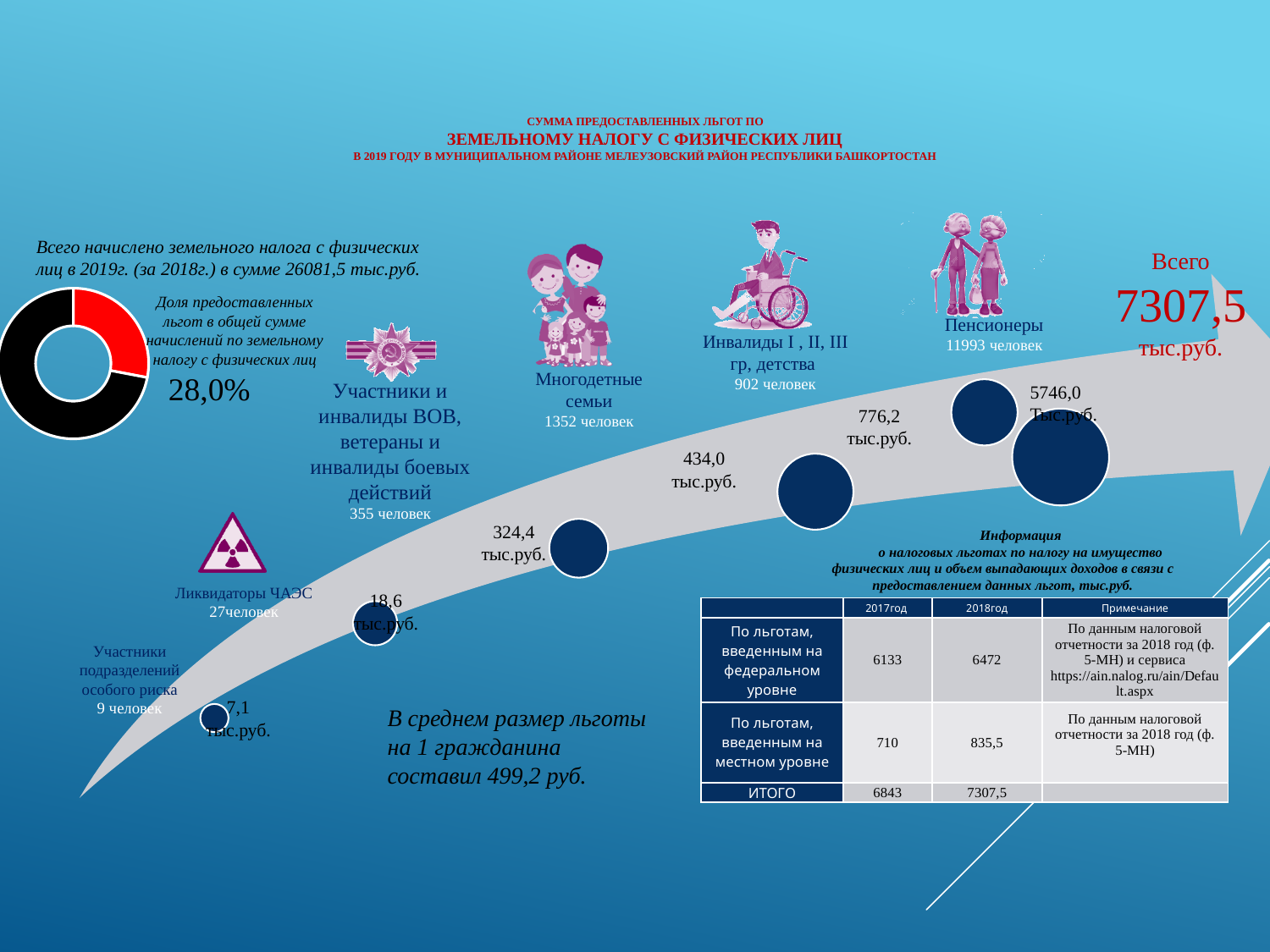
What is the total benefit amount shown at the end of the arrow diagram? 7307,5 тыс.руб. In the arrow diagram, what is the benefit amount shown for large families (Многодетные семьи)? 434,0 тыс.руб. In the donut chart, is the red slice greater or less than 50%? less What does the donut chart represent, according to the text beside it? Доля предоставленных льгот в общей сумме начислений по земельному налогу с физических лиц In the donut chart, what share of total land tax accruals do the granted benefits represent? 28,0% In the arrow diagram, which category has the largest benefit amount? Пенсионеры In the arrow diagram, which category has the smallest benefit amount? Участники подразделений особого риска In the arrow diagram, what is the benefit amount shown for participants of special-risk units (Участники подразделений особого риска)? 7,1 тыс.руб. What kind of chart is shown on the left of the slide next to the text about the share of benefits? donut chart In the arrow diagram, what is the benefit amount shown for pensioners? 5746,0 тыс.руб. How many slices does the donut chart have? 2 In the donut chart, which slice is larger, the red one or the black one? black